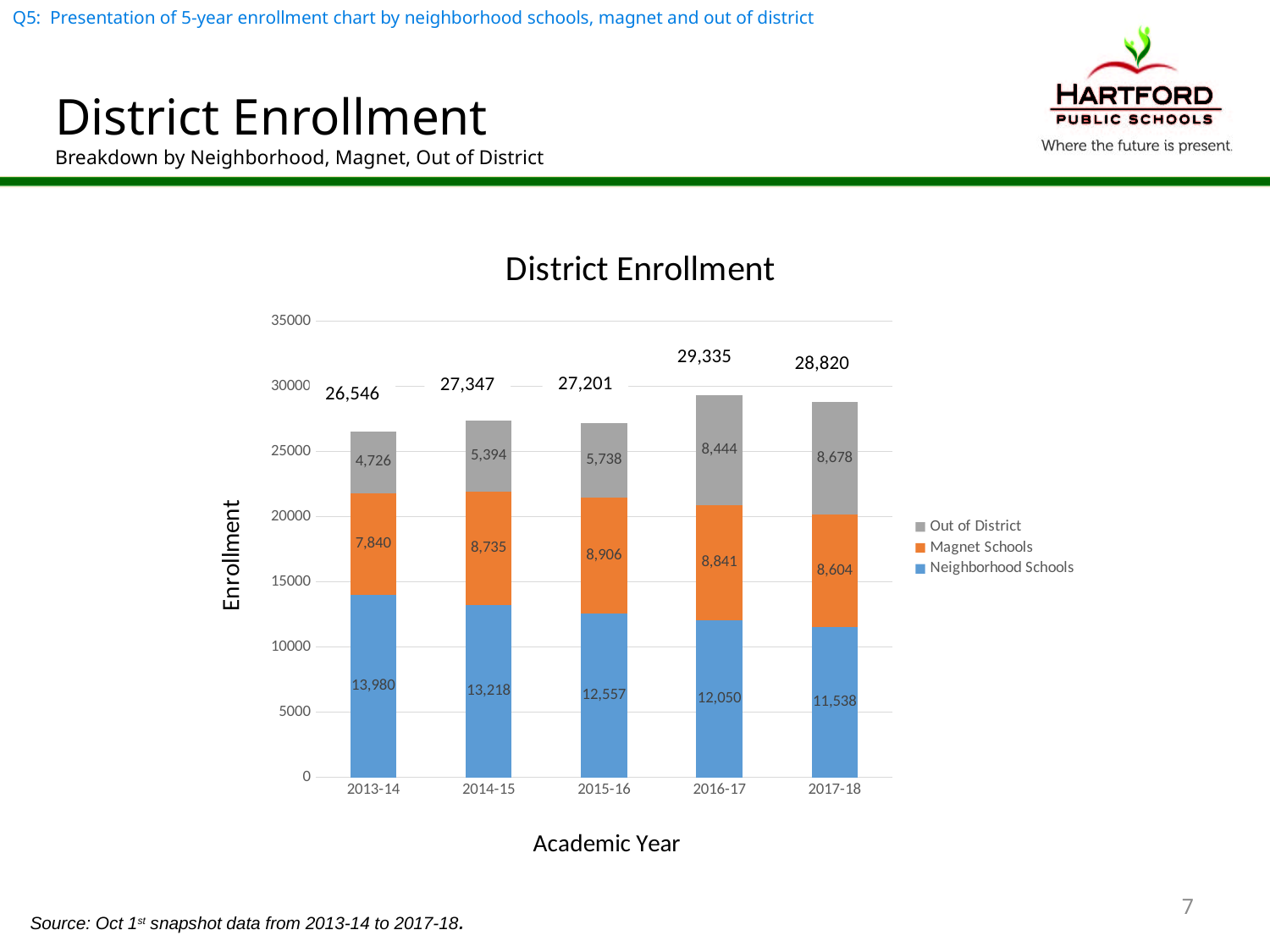
What is the difference between the Out of District enrollment in 2016-17 and in 2015-16? 2,706 How many series does the legend list? 3 How many academic years are shown on the x axis? 5 Does Neighborhood Schools enrollment rise or fall from 2013-14 to 2017-18? Fall What is the total district enrollment for 2016-17? 29,335 What type of chart is shown on the slide? Stacked bar chart Which academic year has the highest total enrollment? 2016-17 Which is larger, the Magnet Schools enrollment in 2014-15 or in 2017-18? 2014-15 What is the Magnet Schools enrollment for 2015-16? 8,906 Which academic year has the lowest Neighborhood Schools enrollment? 2017-18 What is the Out of District enrollment for 2017-18? 8,678 What is the Neighborhood Schools enrollment for 2013-14? 13,980